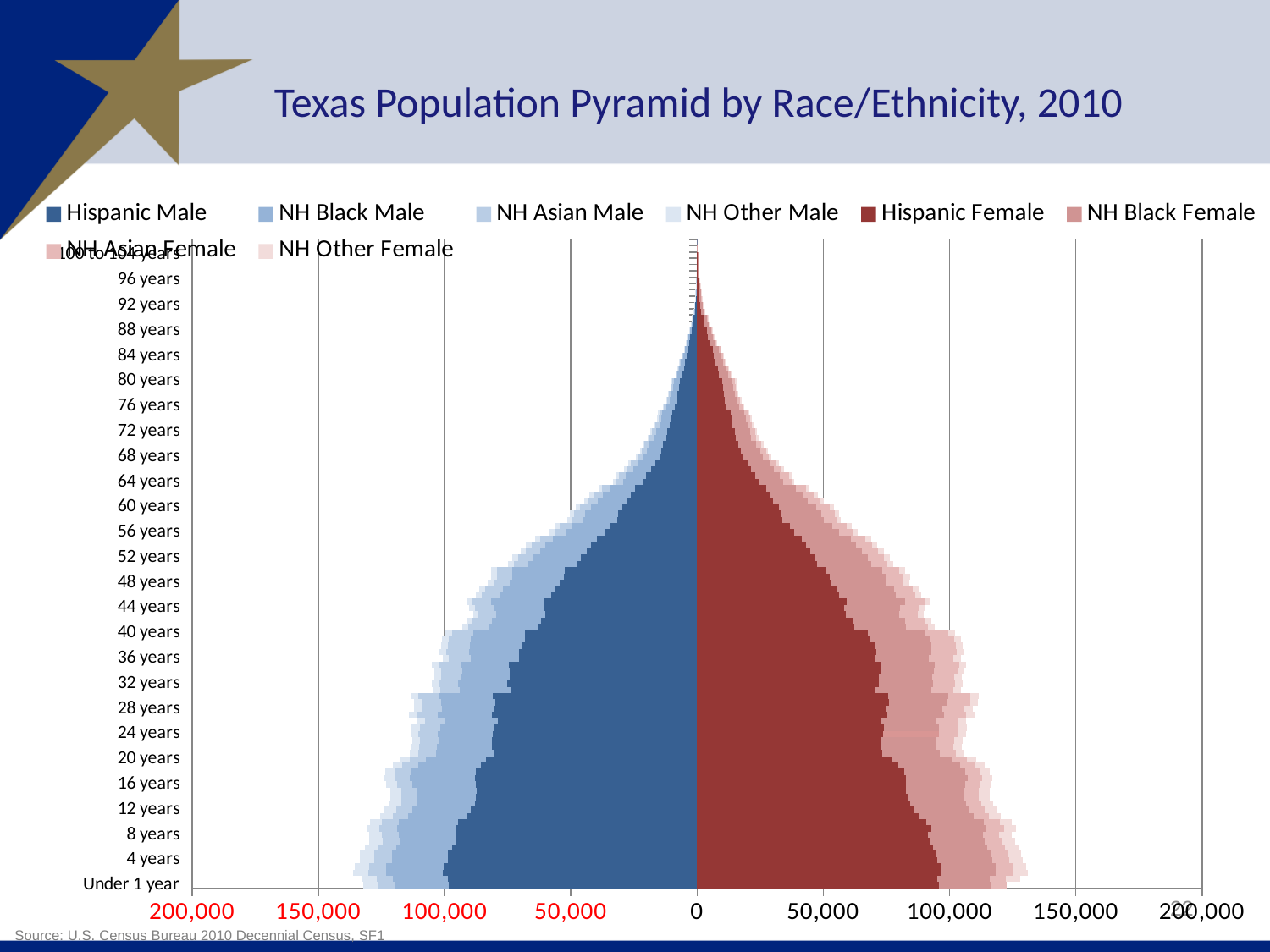
Which is larger at 60 years: the Hispanic Female value or the NH Black Female value? Hispanic Female Is the Hispanic Male value for 80 years greater or less than 50,000? less Which is larger for Hispanic Male: the value at 4 years or the value at 80 years? 4 years What kind of chart is shown on the slide? Bar chart (population pyramid) Is the Hispanic Female value for Under 1 year greater or less than 50,000? greater Is the total male population (all races combined) for Under 1 year greater or less than 100,000? greater How many series does the legend list? 8 Moving from the youngest age groups to the oldest, do the total bar lengths generally increase or decrease? decrease Which series is shown in dark red on the right side of the pyramid? Hispanic Female What is the title of the chart? Texas Population Pyramid by Race/Ethnicity, 2010